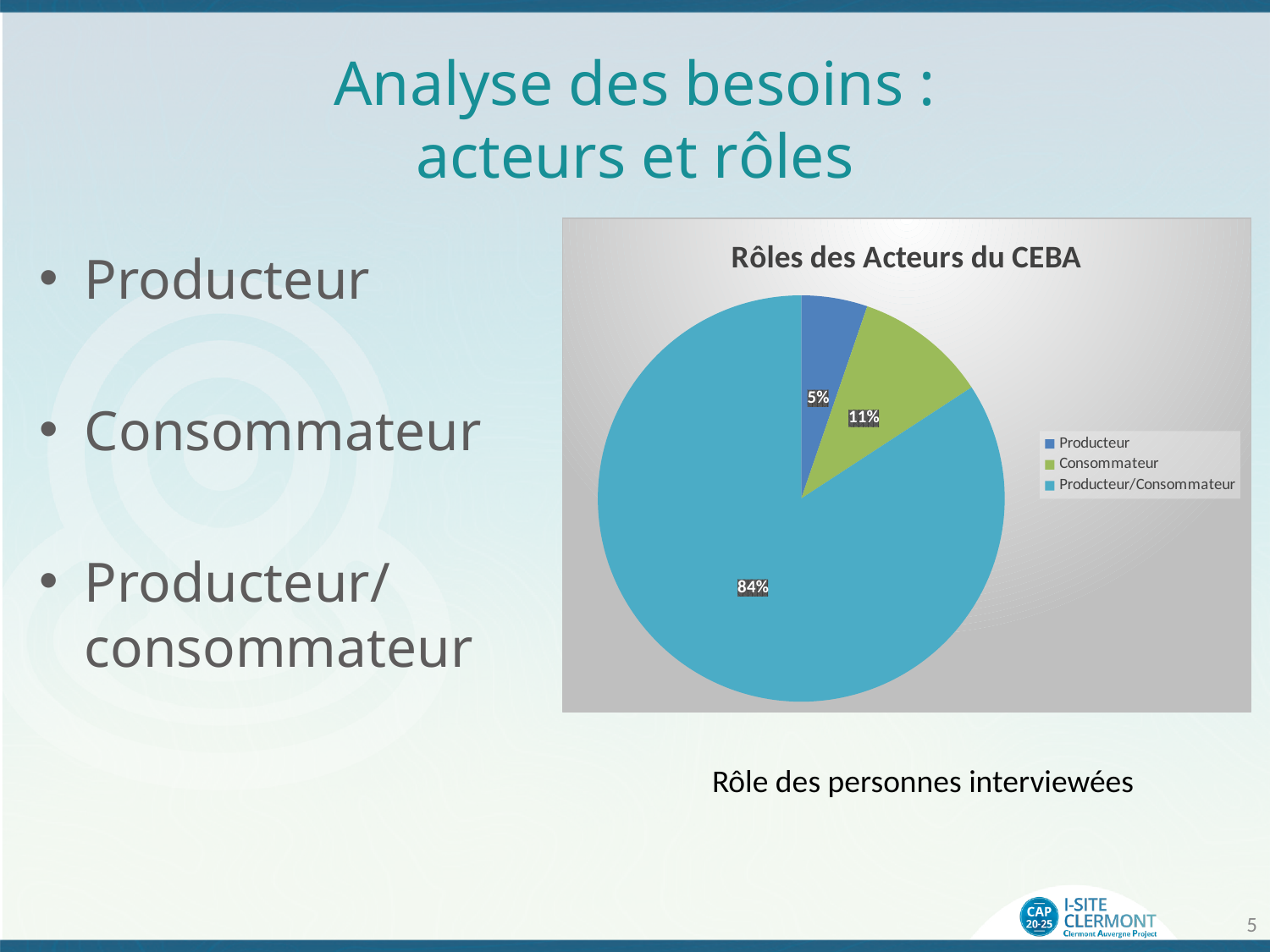
How many categories does the pie chart show? 3 How many entries does the legend list? 3 Which category has the smallest slice? Producteur Which is larger, the Consommateur slice or the Producteur slice? Consommateur What kind of chart is shown on the slide? pie chart What colour is the Producteur/Consommateur slice? light blue What share of the pie is Consommateur? 11% What share of the pie is Producteur? 5% Which category has the largest slice? Producteur/Consommateur What is the difference between the Consommateur and Producteur shares? 6% What share of the pie is Producteur/Consommateur? 84% What is the chart's title? Rôles des Acteurs du CEBA